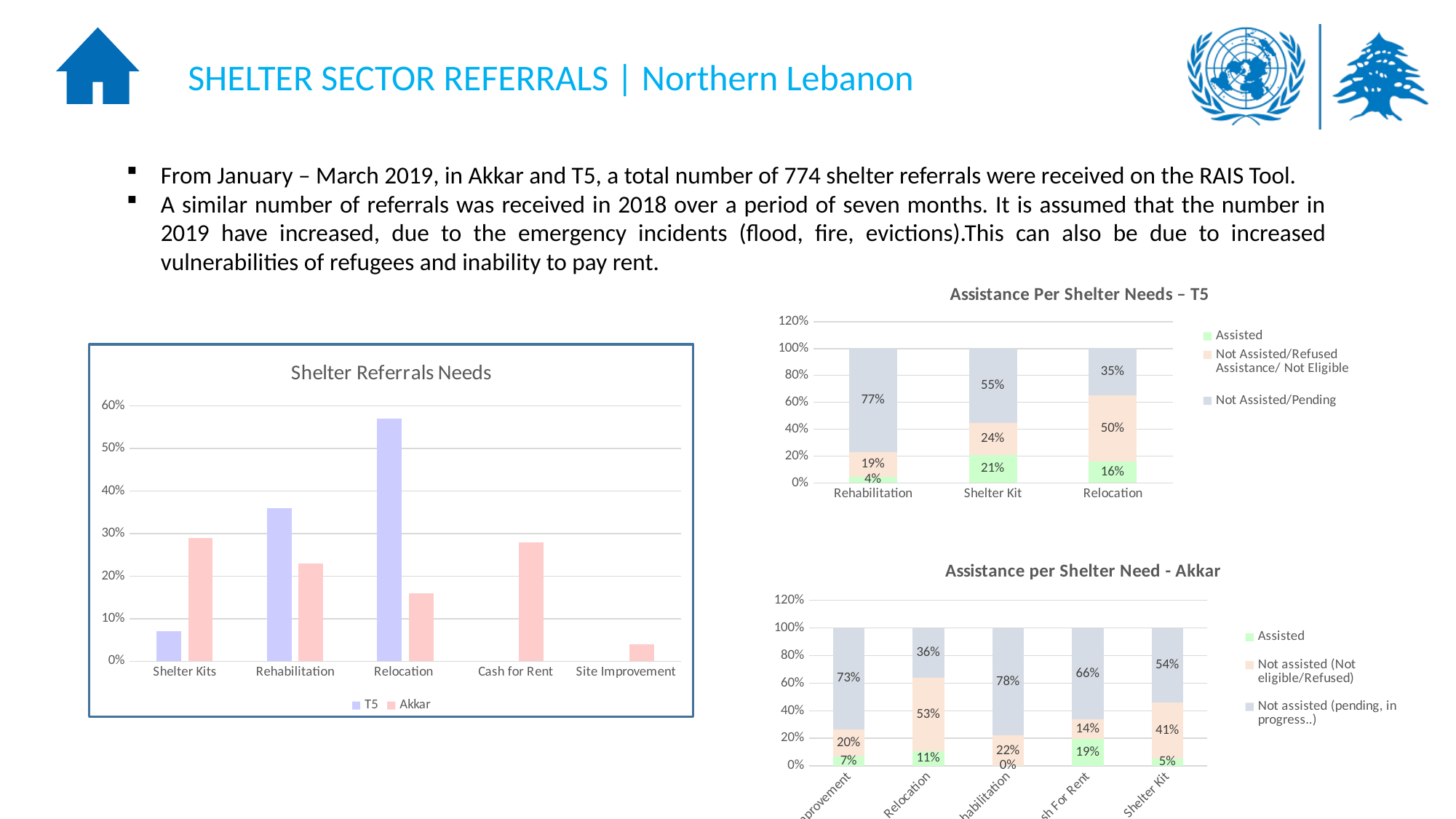
In the "Shelter Referrals Needs" chart, is the T5 value for Relocation greater or less than 50%? greater In the "Shelter Referrals Needs" chart, which category has the highest T5 value? Relocation In the "Assistance Per Shelter Needs – T5" chart, what is the Assisted share for Shelter Kit? 21% In the "Assistance Per Shelter Needs – T5" chart, what is the difference between the Not Assisted/Refused Assistance/ Not Eligible share for Relocation and for Rehabilitation? 31 percentage points In the "Assistance per Shelter Need - Akkar" chart, what is the Not assisted (Not eligible/Refused) share for Relocation? 53% In the "Shelter Referrals Needs" chart, how many series does the legend list? 2 In the "Assistance per Shelter Need - Akkar" chart, how many series does the legend list? 3 In the "Assistance Per Shelter Needs – T5" chart, which category has the highest Assisted share? Shelter Kit In the "Shelter Referrals Needs" chart, how many categories are shown on the x axis? 5 What kind of chart is the "Shelter Referrals Needs" chart? bar chart In the "Assistance Per Shelter Needs – T5" chart, what is the Not Assisted/Pending share for Rehabilitation? 77% In the "Shelter Referrals Needs" chart, which series has the larger value for Shelter Kits, T5 or Akkar? Akkar